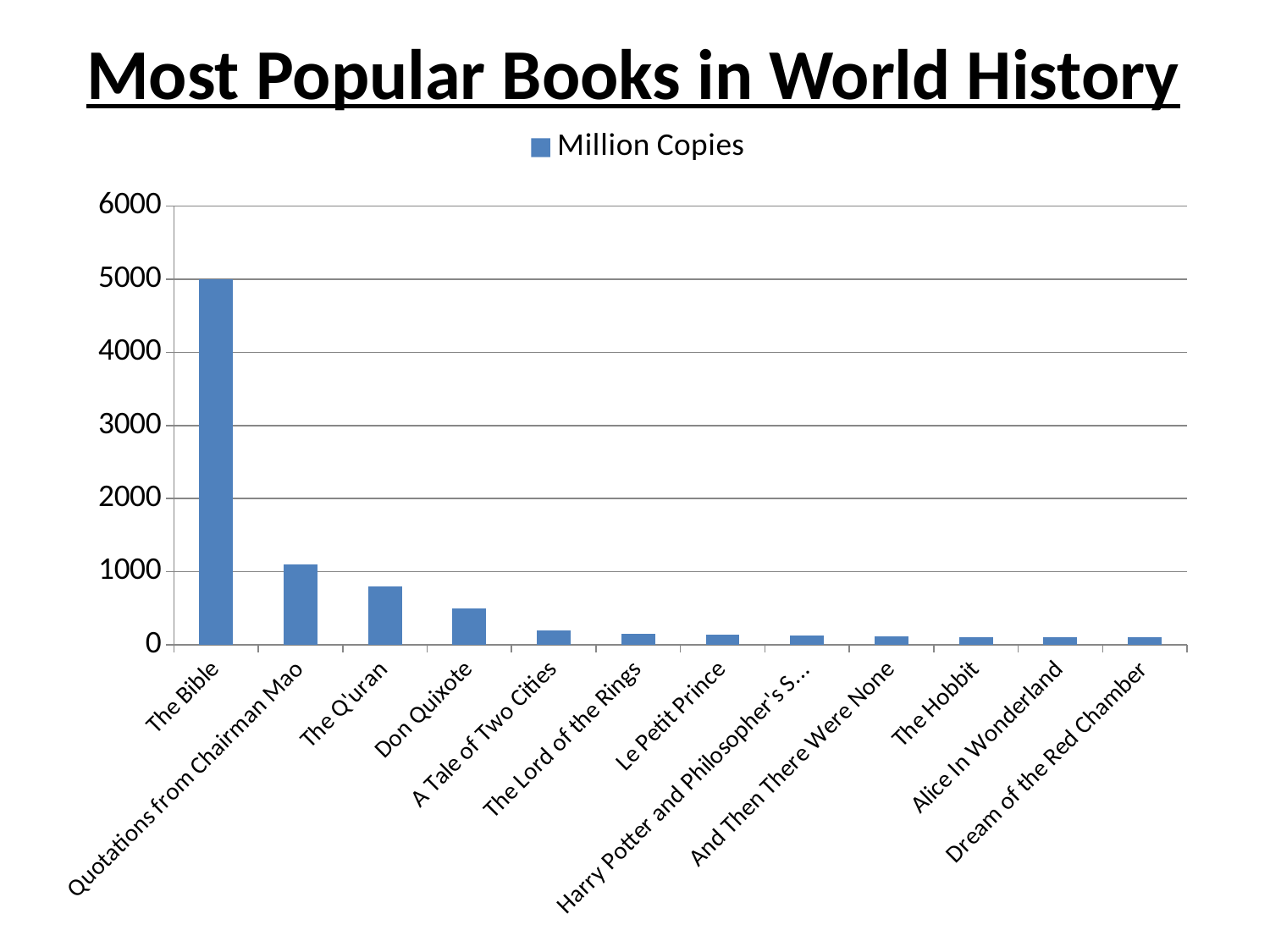
What is the title of the slide? Most Popular Books in World History What kind of chart is shown on the slide? bar chart What is the name of the series shown in the legend? Million Copies Which is larger, the value for The Q'uran or the value for Don Quixote? The Q'uran What is the value for The Bible in million copies? 5000 How many books (categories) are plotted on the chart? 12 Do the values rise or fall moving from left to right along the x axis? fall Which book has the highest value on the chart? The Bible Is the value for Quotations from Chairman Mao greater or less than 1000? greater Is the value for The Q'uran greater or less than 1000? less How many series does the legend list? 1 Is the value for Don Quixote greater or less than 1000? less